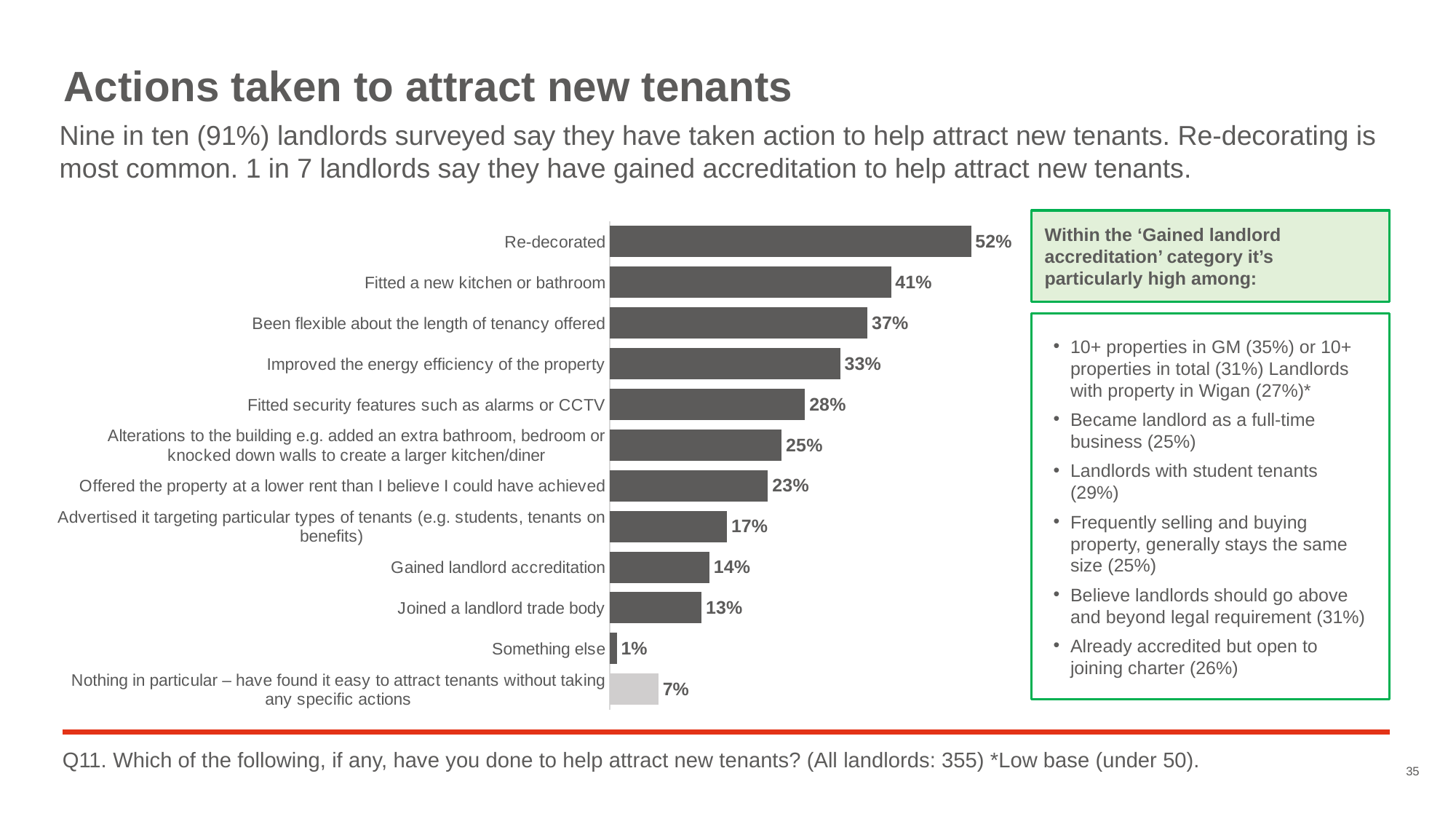
What is the difference in percentage points between 'Re-decorated' and 'Fitted a new kitchen or bathroom'? 11 percentage points What percentage of landlords fitted security features such as alarms or CCTV? 28% What is the value for 'Gained landlord accreditation'? 14% Which bar in the chart is shown in a lighter grey colour than the others? Nothing in particular – have found it easy to attract tenants without taking any specific actions What type of chart is shown on the slide? Bar chart What is the difference in percentage points between 'Gained landlord accreditation' and 'Joined a landlord trade body'? 1 percentage point Which action has the highest percentage in the chart? Re-decorated Which is larger: the value for 'Improved the energy efficiency of the property' or the value for 'Offered the property at a lower rent than I believe I could have achieved'? Improved the energy efficiency of the property Which category has the lowest percentage in the chart? Something else How many categories are shown in the bar chart? 12 What is the value for 'Nothing in particular – have found it easy to attract tenants without taking any specific actions'? 7% What percentage of landlords say they have re-decorated to attract new tenants? 52%